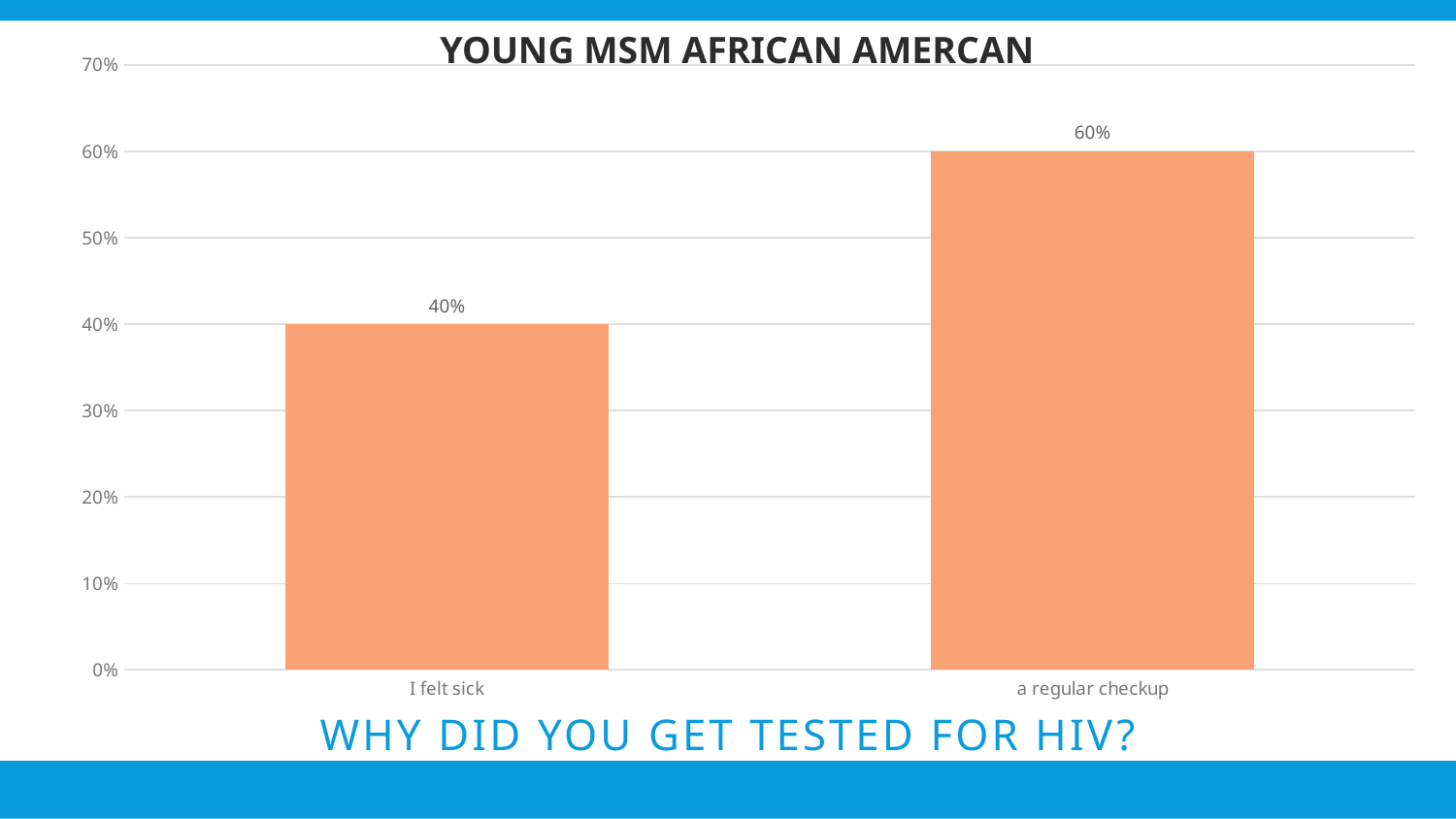
What is the difference between the values for "a regular checkup" and "I felt sick"? 20% Which category has the highest value? a regular checkup Is the value for "I felt sick" greater or less than 50%? less How many categories are shown in the chart? 2 Which is larger, the value for "I felt sick" or the value for "a regular checkup"? a regular checkup What is the highest value shown on the vertical axis? 70% Is the value for "a regular checkup" greater or less than 50%? greater What is the value for "I felt sick"? 40% Which category has the lowest value? I felt sick What is the title of the chart? YOUNG MSM AFRICAN AMERCAN What kind of chart is shown on the slide? bar chart What is the value for "a regular checkup"? 60%